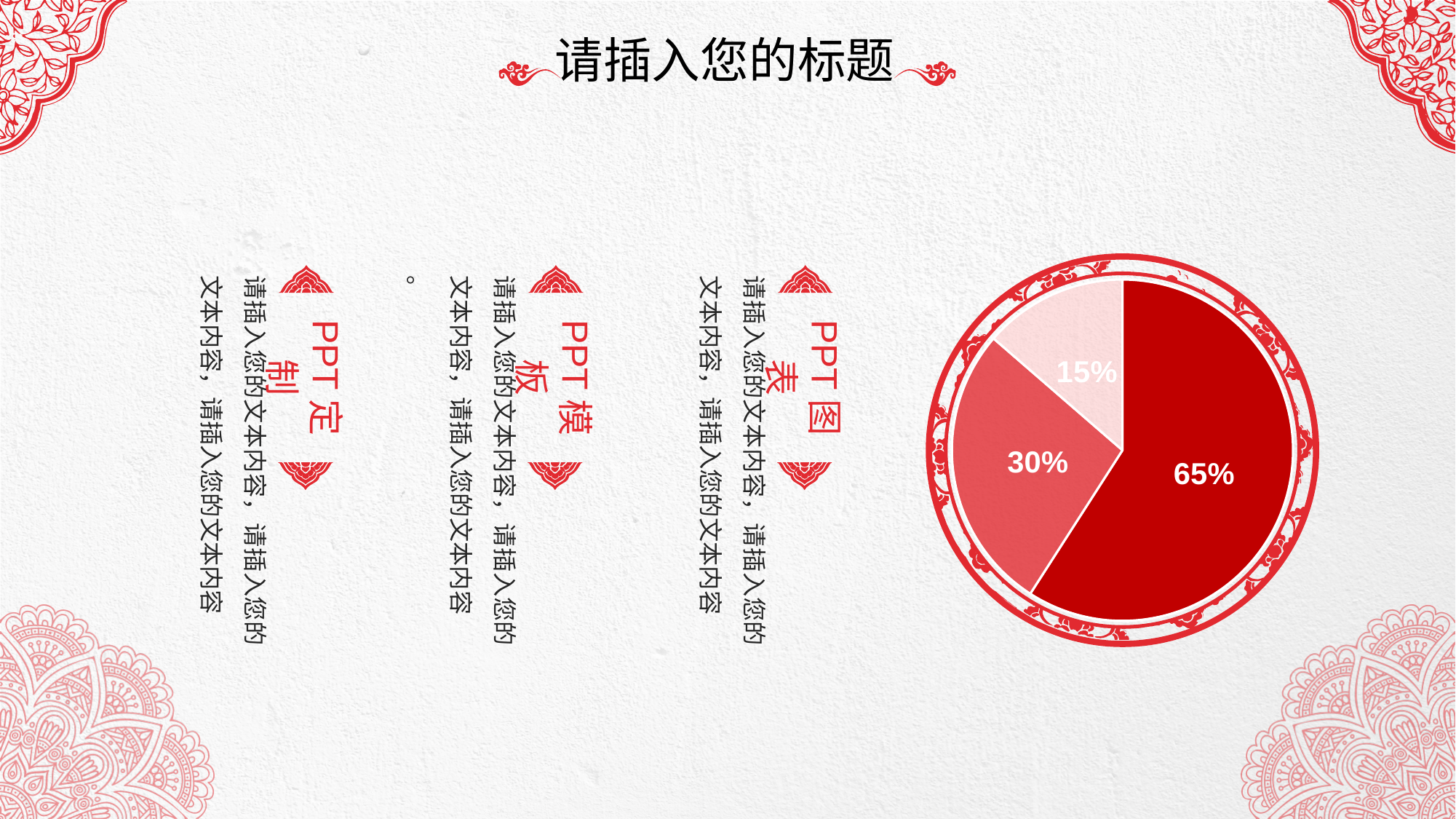
What value is labelled on the smallest slice of the pie chart? 15% Which slice is larger in the pie chart, the medium red one or the light pink one? the medium red one What is the difference between the 65% slice and the 30% slice in the pie chart? 35% What value is labelled on the dark red slice of the pie chart? 65% What is the difference between the largest and smallest slice values in the pie chart? 50% What value is labelled on the largest slice of the pie chart? 65% What value is labelled on the medium red slice of the pie chart? 30% How many slices does the pie chart have? 3 Does the pie chart have a legend? No What value is labelled on the light pink slice of the pie chart? 15% What colour is the largest slice of the pie chart? dark red What kind of chart is shown on the slide? pie chart